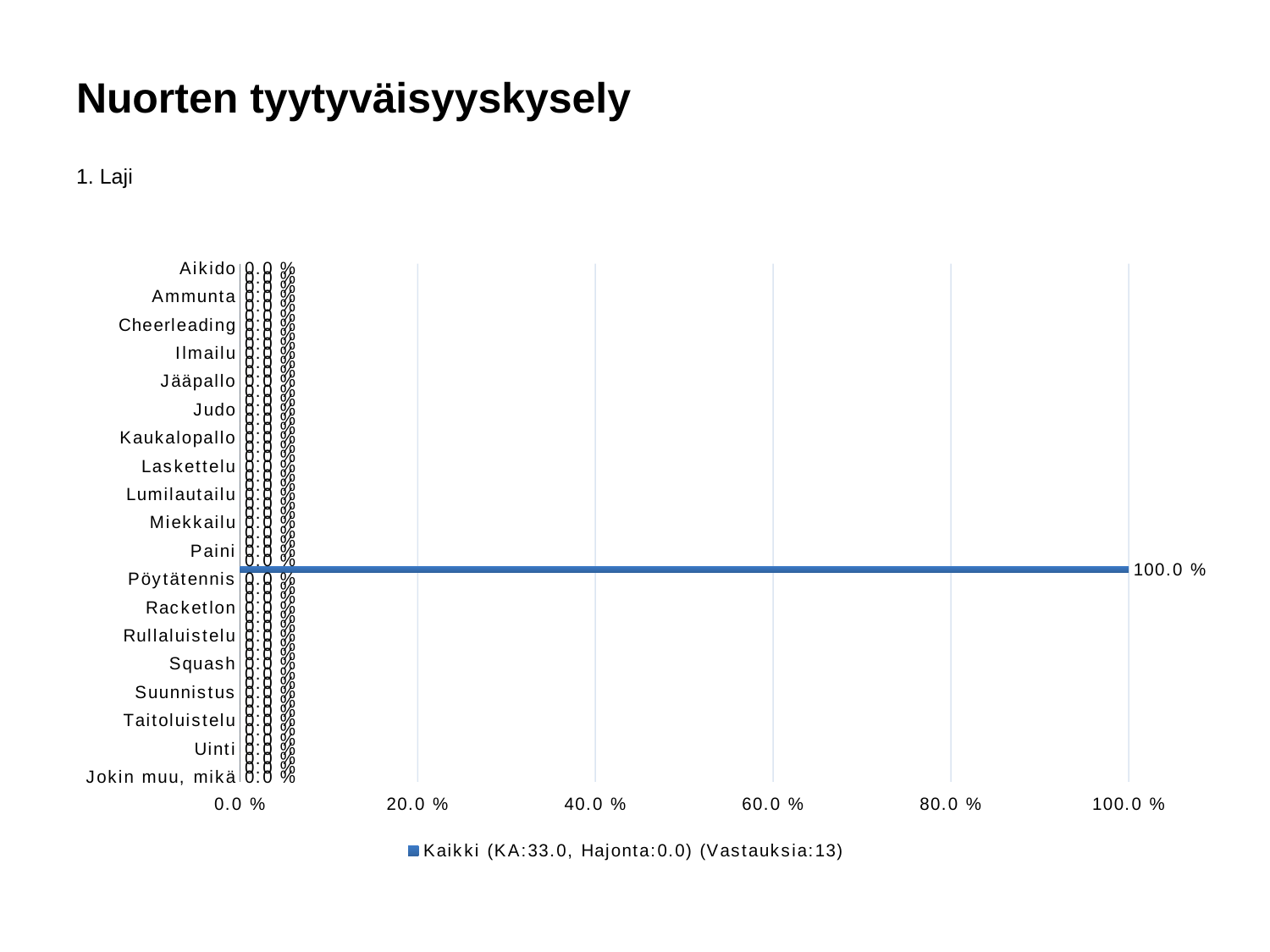
Which is larger, the value for Pöytätennis or the value for Judo? Neither; both are 0.0 % Is the value for Pöytätennis greater or less than 80.0 %? less How many series does the legend list? 1 How many categories are listed on the vertical axis? 19 What is the difference between the value for Pöytätennis and the value for Squash? 0.0 % What is the value for Pöytätennis? 0.0 % What is the label of the last category at the bottom of the vertical axis? Jokin muu, mikä What is the value for Uinti? 0.0 % What is the legend entry for the series? Kaikki (KA:33.0, Hajonta:0.0) (Vastauksia:13) What is the value for Aikido? 0.0 % What kind of chart is shown on the slide? bar chart